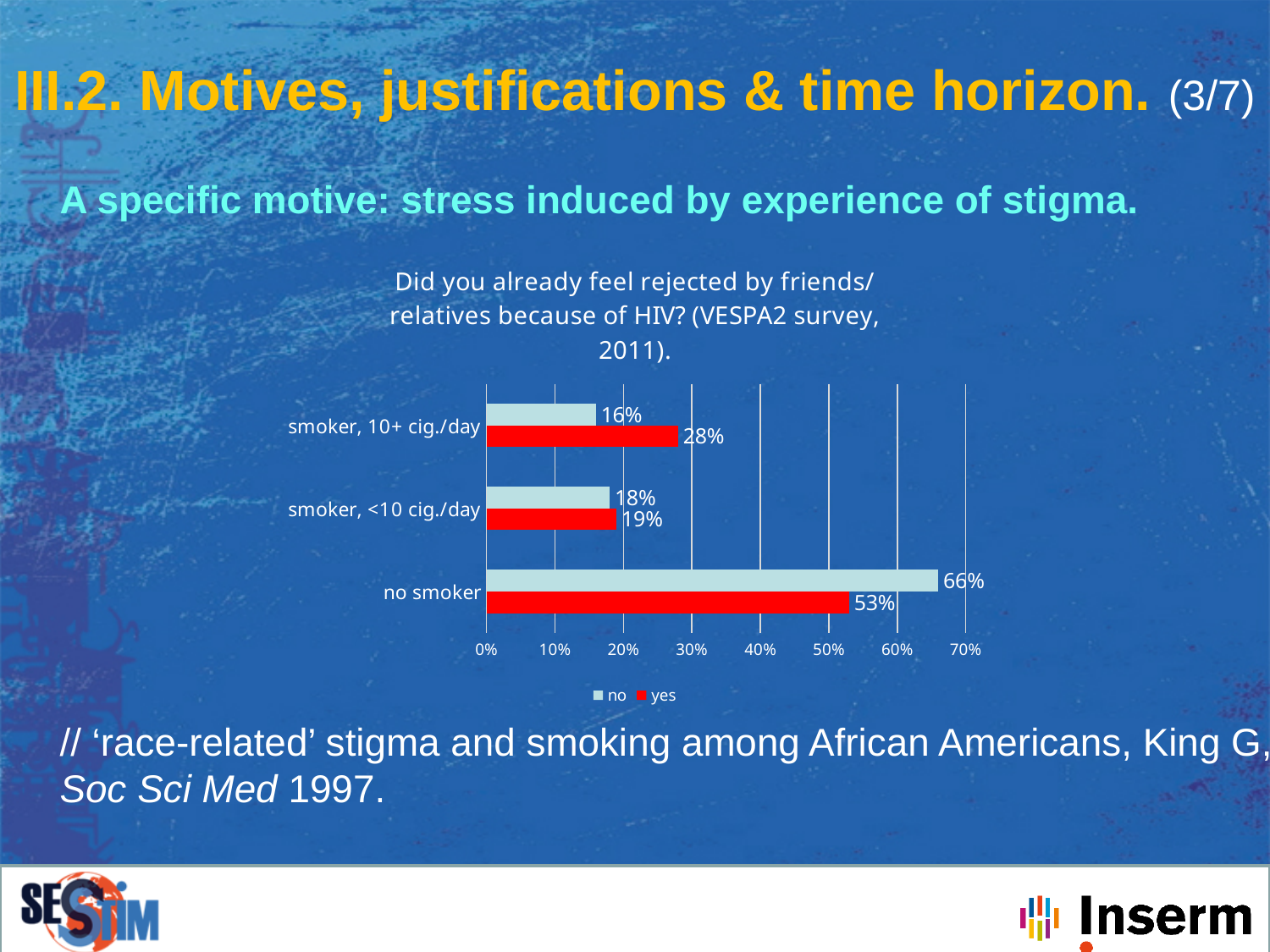
For 'smoker, 10+ cig./day', which is larger: the 'no' value or the 'yes' value? yes What is the value of the 'yes' series for 'smoker, <10 cig./day'? 19% Which colour represents the 'yes' series in the chart? red Which category has the lowest value in the 'no' series? smoker, 10+ cig./day How many series does the legend list? 2 What is the value of the 'yes' series for 'smoker, 10+ cig./day'? 28% What is the difference between the 'no' and 'yes' values for 'no smoker'? 13% What is the value of the 'no' series for 'no smoker'? 66% Which category has the highest value in the 'yes' series? no smoker What kind of chart is shown on the slide? bar chart How many categories are shown on the chart? 3 What is the value of the 'no' series for 'smoker, 10+ cig./day'? 16%